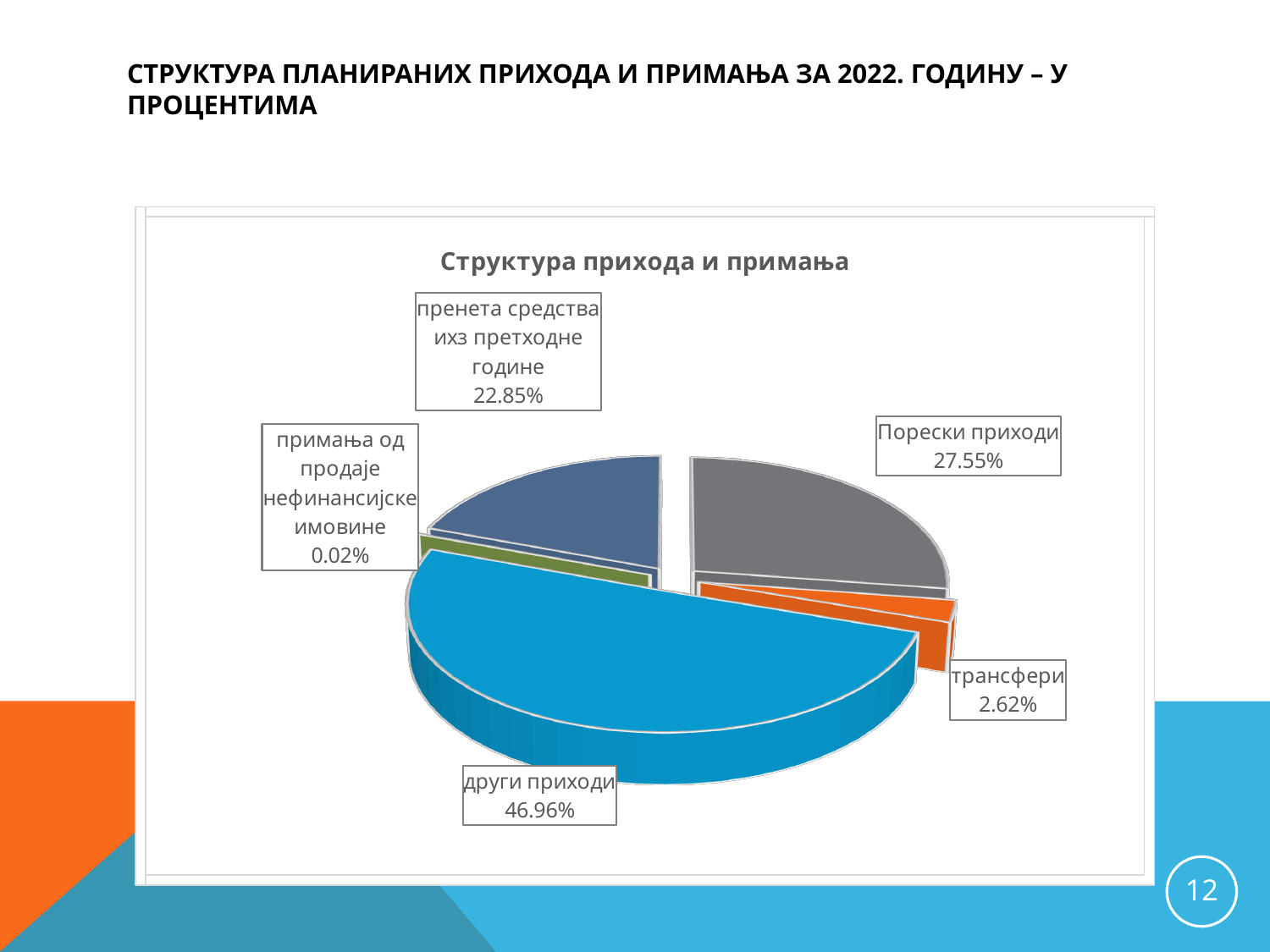
What kind of chart is shown on the slide? pie chart What share of the pie is labelled for пренета средства ихз претходне године? 22.85% What share of the pie is labelled for примања од продаје нефинансијске имовине? 0.02% What share of the pie is labelled for други приходи? 46.96% What is the difference between the share for други приходи and the share for Порески приходи? 19.41% What is the title of the chart? Структура прихода и примања Which is larger, the share for Порески приходи or the share for пренета средства ихз претходне године? Порески приходи What share of the pie is labelled for трансфери? 2.62% How many slices does the pie chart have? 5 Which category has the smallest share of the pie? примања од продаје нефинансијске имовине What share of the pie is labelled for Порески приходи? 27.55% Which category has the largest share of the pie? други приходи